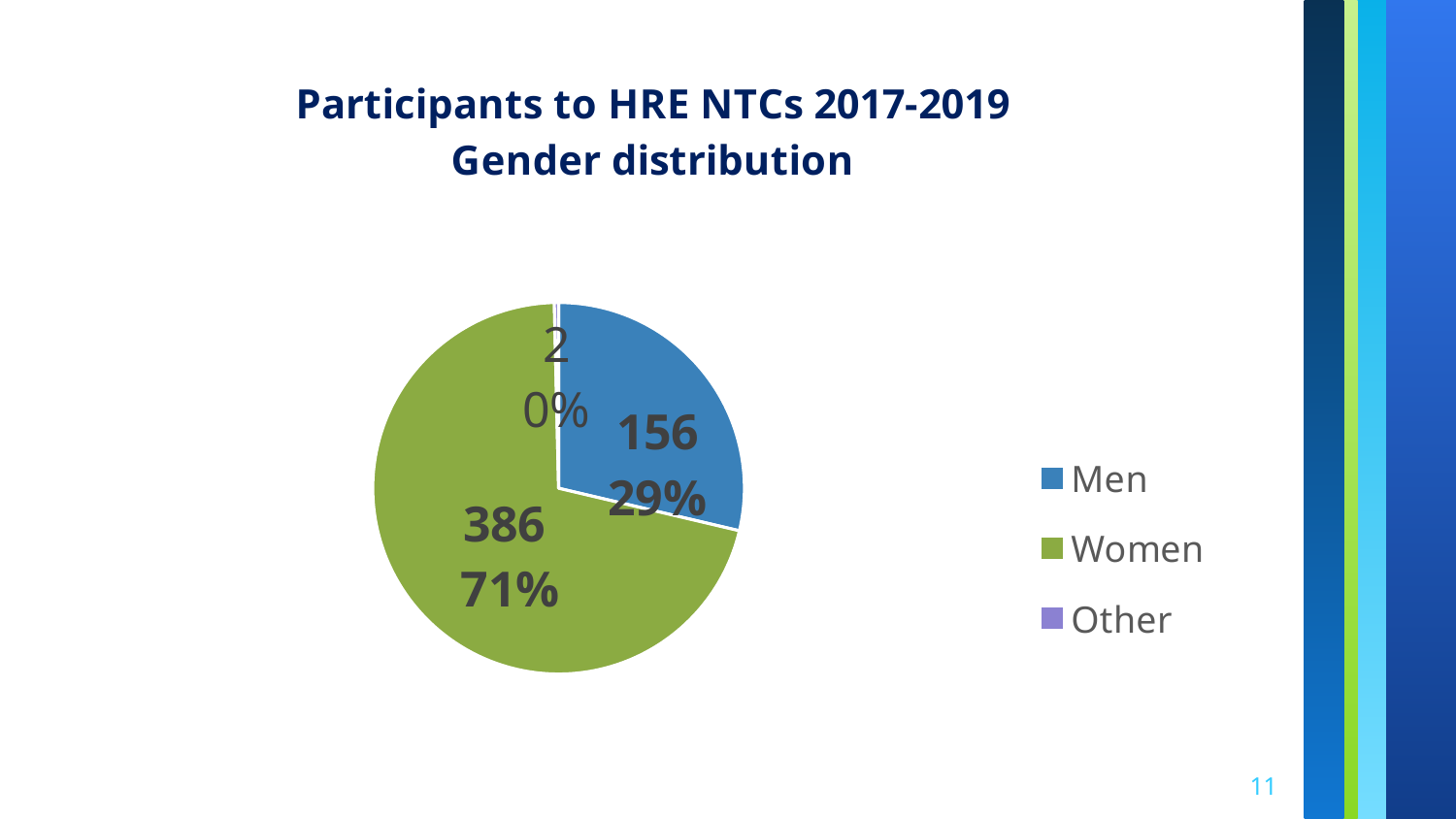
How many participants are in the Other category? 2 What is the title of the chart? Participants to HRE NTCs 2017-2019 Gender distribution What percentage of participants were women? 71% What percentage of participants were men? 29% How many participants were women? 386 Which category has the smallest slice of the pie? Other Which category has the largest slice of the pie? Women What percentage is shown for the Other category? 0% How many participants were men? 156 How many more women than men participated? 230 What kind of chart is shown on the slide? pie chart How many categories does the legend list? 3